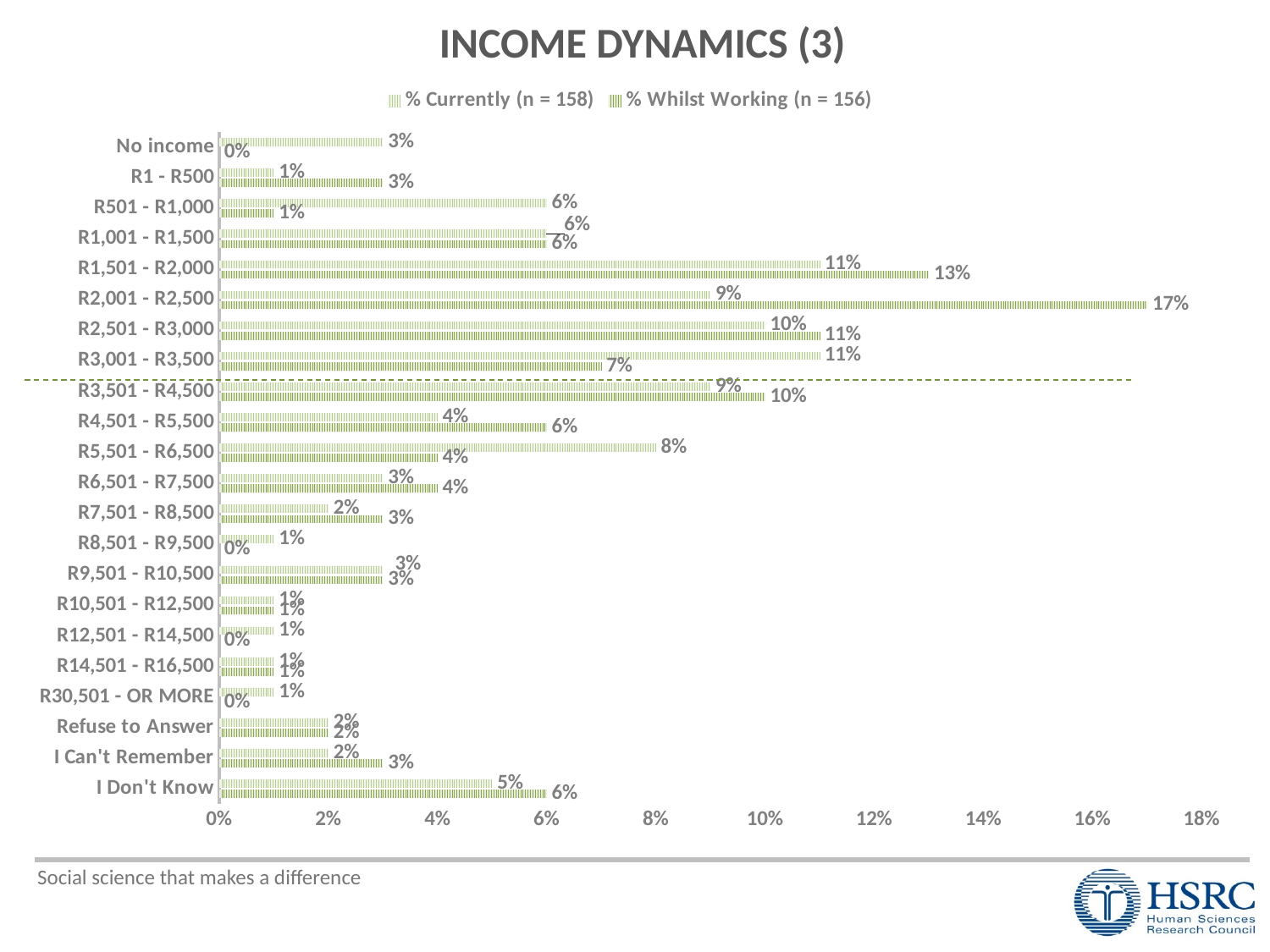
What is the difference between the % Whilst Working and % Currently values for R2,001 - R2,500? 8% What is the % Whilst Working value for R2,001 - R2,500? 17% What is the % Whilst Working value for R1,501 - R2,000? 13% What is the % Currently value for R5,501 - R6,500? 8% What are the two series named in the legend? % Currently (n = 158) and % Whilst Working (n = 156) How many series does the legend list? 2 What is the % Whilst Working value for No income? 0% For R3,001 - R3,500, which is larger: % Currently or % Whilst Working? % Currently Which income category has the highest % Whilst Working value? R2,001 - R2,500 What type of chart is shown on the slide? bar chart What is the % Currently value for I Don't Know? 5% For R4,501 - R5,500, which is larger: % Currently or % Whilst Working? % Whilst Working